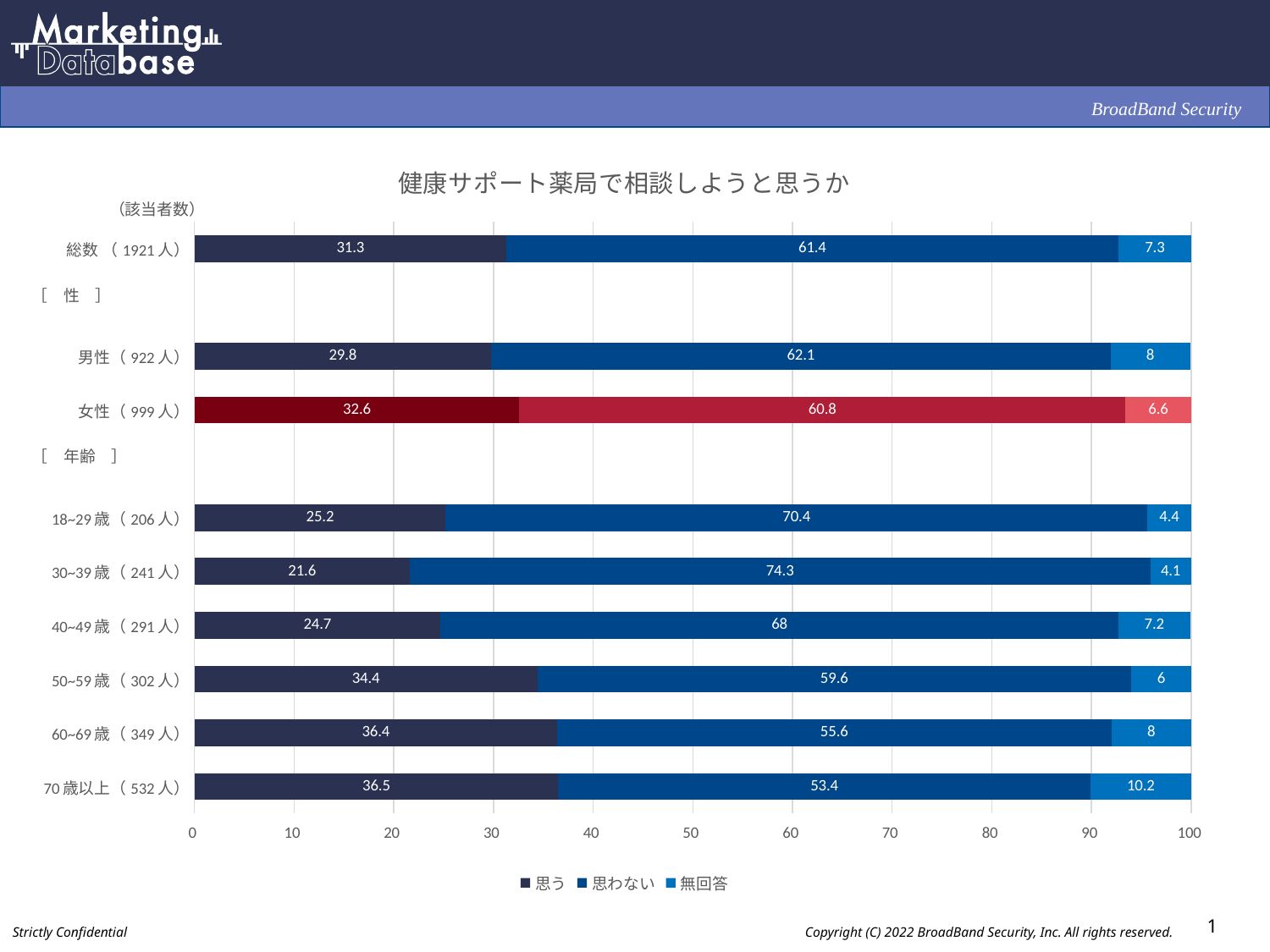
What is the title of the chart? 健康サポート薬局で相談しようと思うか Which is larger, the 思わない value for 18~29歳 (206人) or for 50~59歳 (302人)? 18~29歳 (206人) What type of chart is shown on the slide? Stacked bar chart Which category has the lowest value for 思う? 30~39歳 (241人) What is the total of the stacked bar for 総数 (1921人)? 100 How many categories have bars plotted in the chart? 9 What is the value of 思う for 総数 (1921人)? 31.3 How many series does the legend list? 3 What is the value of 思わない for 女性 (999人)? 60.8 What is the difference between the 思う values for 女性 (999人) and 男性 (922人)? 2.8 Which category has the highest value for 思わない? 30~39歳 (241人) What is the value of 無回答 for 70歳以上 (532人)? 10.2